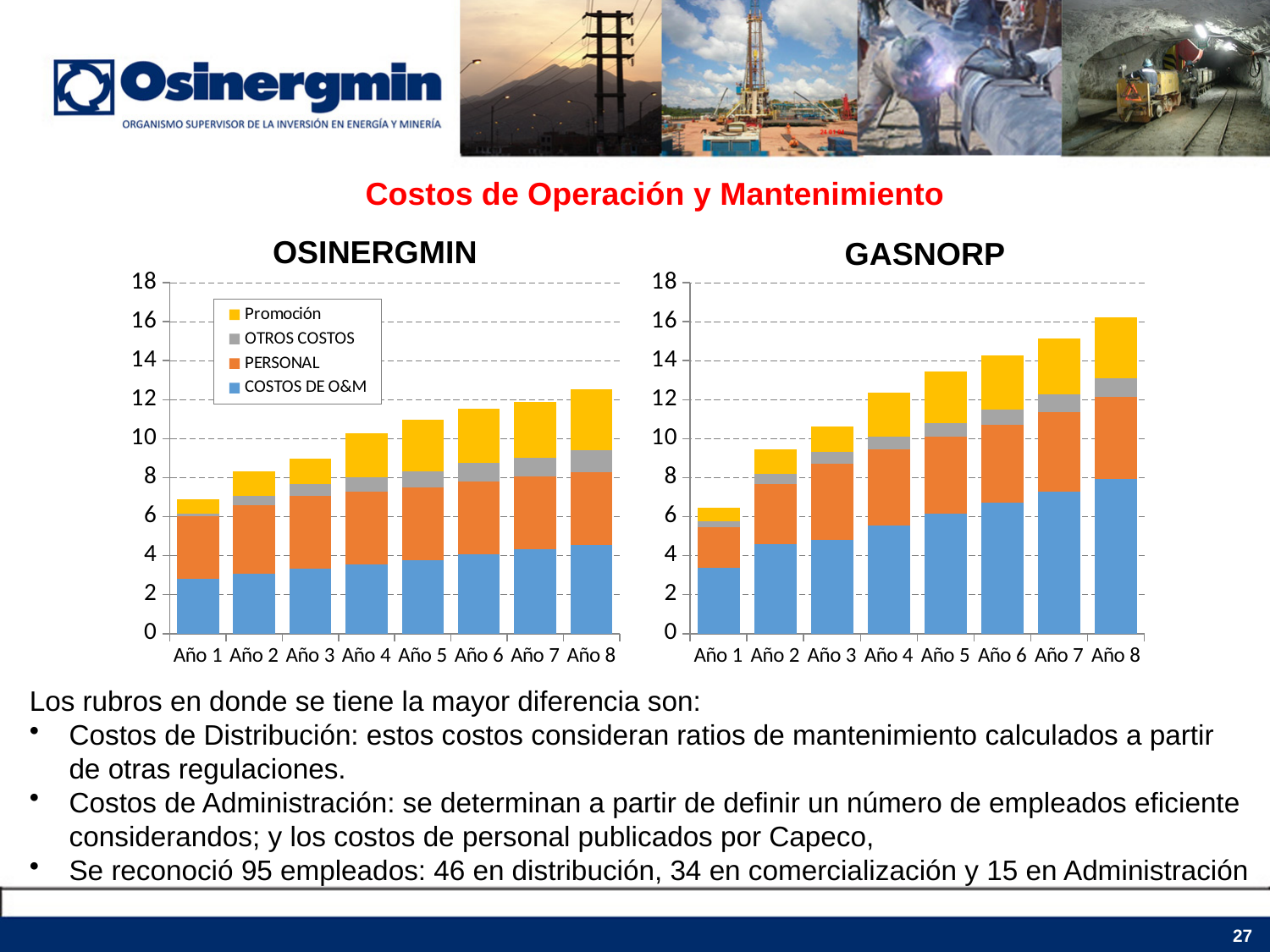
In the OSINERGMIN chart, which series is shown in yellow according to the legend? Promoción In the OSINERGMIN chart, is the total value for Año 1 greater or less than 8? less In the GASNORP chart, which year has the shortest total bar? Año 1 How many series does the legend of the OSINERGMIN chart list? 4 In the OSINERGMIN chart, is the total value for Año 8 greater or less than 12? greater In the GASNORP chart, do the total bar heights rise or fall from Año 1 to Año 8? rise How many categories (years) are shown on the x axis of the GASNORP chart? 8 In the GASNORP chart, is the total value for Año 5 greater or less than 12? greater In the OSINERGMIN chart, which year has the tallest total bar? Año 8 Which chart has the taller total bar for Año 8, OSINERGMIN or GASNORP? GASNORP What kind of chart is the OSINERGMIN chart? stacked bar chart